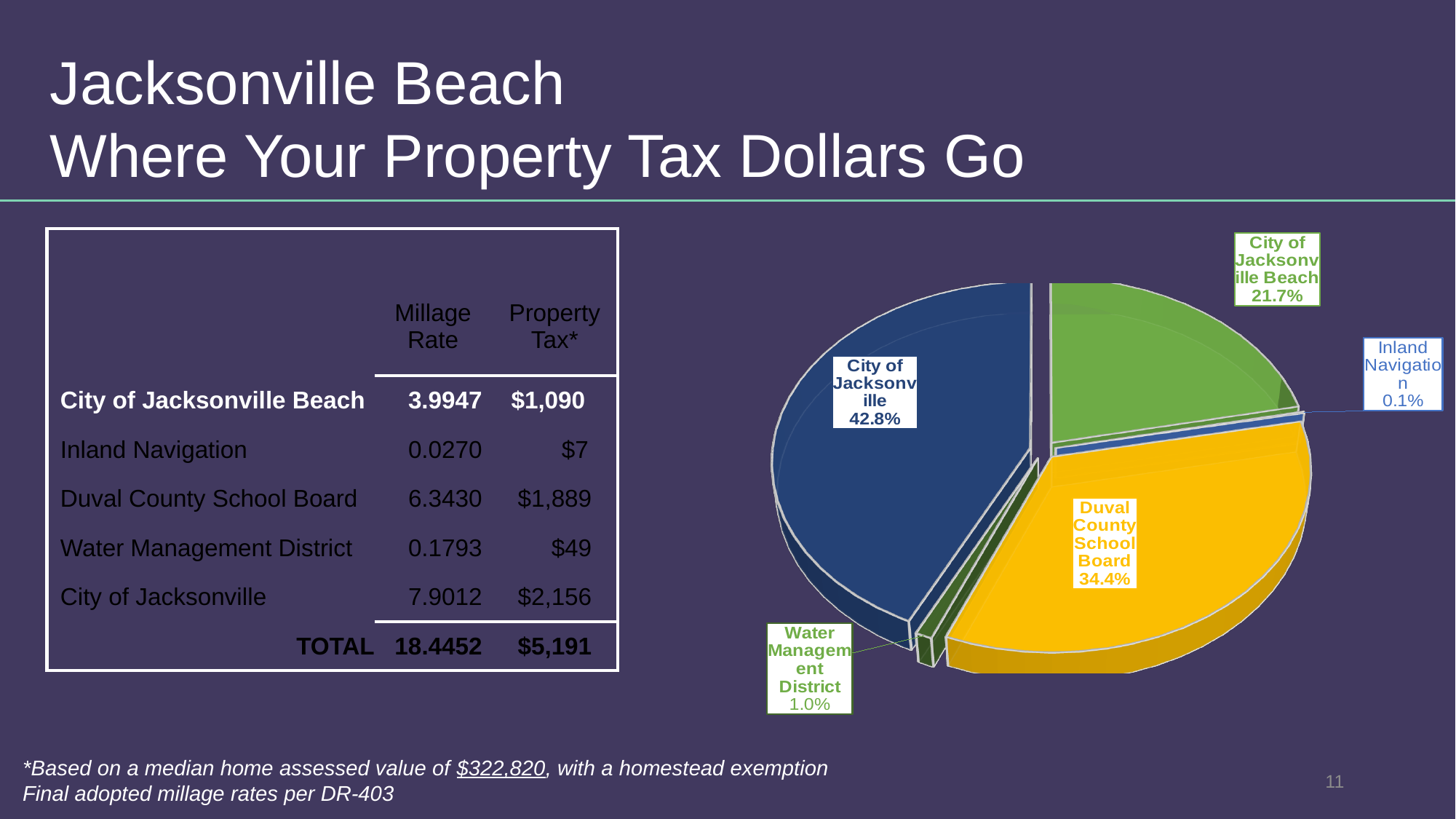
In the pie chart, what share is labelled for City of Jacksonville Beach? 21.7% In the pie chart, what share is labelled for Water Management District? 1.0% What colour is the Duval County School Board slice in the pie chart? yellow In the pie chart, which is larger: the share for Duval County School Board or the share for City of Jacksonville Beach? Duval County School Board In the pie chart, what share is labelled for City of Jacksonville? 42.8% Which slice of the pie chart is the largest? City of Jacksonville How many slices does the pie chart have? 5 Which slice of the pie chart is the smallest? Inland Navigation What kind of chart is shown on the right of the slide? pie chart In the pie chart, what is the difference in percentage points between the City of Jacksonville share and the Duval County School Board share? 8.4